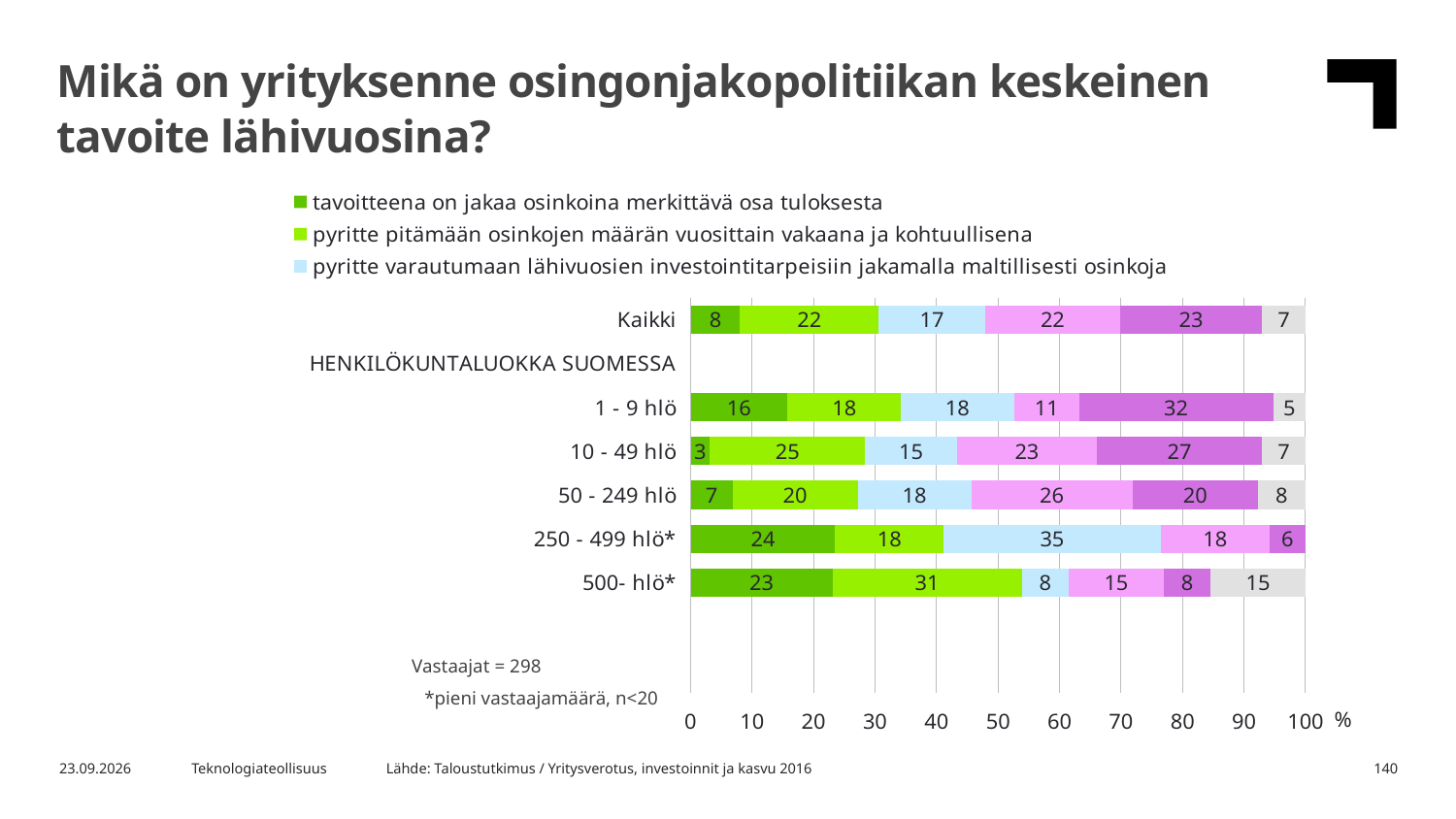
For Kaikki, what is the difference between the 'pyritte pitämään osinkojen määrän vuosittain vakaana ja kohtuullisena' segment and the 'tavoitteena on jakaa osinkoina merkittävä osa tuloksesta' segment? 14 Which has a larger value for 'tavoitteena on jakaa osinkoina merkittävä osa tuloksesta': 1 - 9 hlö or 50 - 249 hlö? 1 - 9 hlö What is the value of the 'tavoitteena on jakaa osinkoina merkittävä osa tuloksesta' segment for Kaikki? 8 What is the value of the 'pyritte pitämään osinkojen määrän vuosittain vakaana ja kohtuullisena' segment for 500- hlö*? 31 What is the value of the 'pyritte varautumaan lähivuosien investointitarpeisiin jakamalla maltillisesti osinkoja' segment for 250 - 499 hlö*? 35 What is the total of all segments in the 1 - 9 hlö bar? 100 What type of chart is shown on the slide? Stacked bar chart Which category has the highest value for 'pyritte varautumaan lähivuosien investointitarpeisiin jakamalla maltillisesti osinkoja'? 250 - 499 hlö* How many respondents (Vastaajat) does the slide report? 298 How many categories have bars plotted in the chart? 6 Which category has the lowest value for 'tavoitteena on jakaa osinkoina merkittävä osa tuloksesta'? 10 - 49 hlö How many entries does the chart legend list? 3